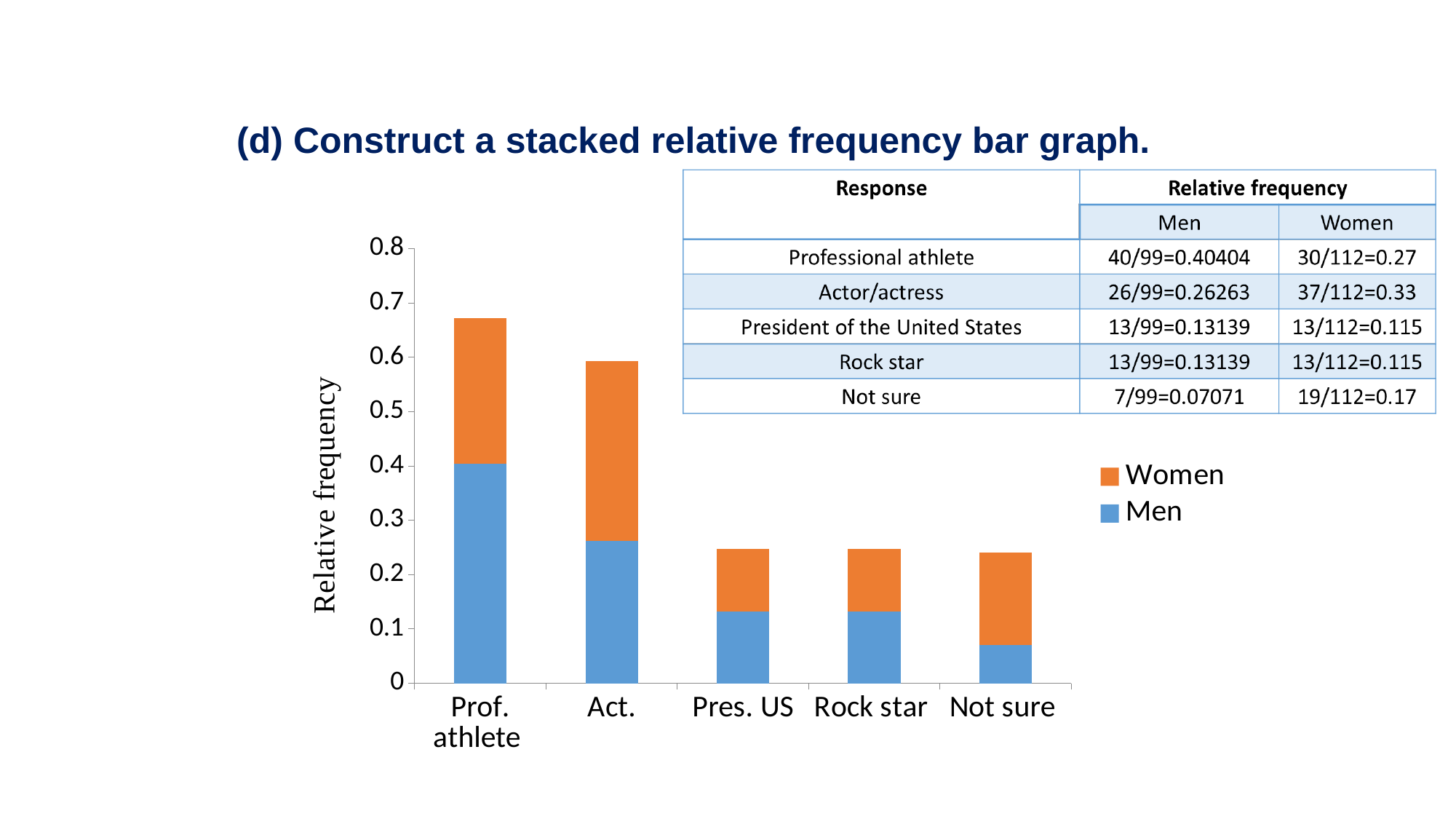
What is the label on the chart's vertical axis? Relative frequency What kind of chart is shown on the slide? bar chart Which colour represents Women in the chart's legend? orange How many series does the chart's legend list? 2 How many categories are shown on the x axis of the chart? 5 For the Not sure bar, which segment is larger, Women or Men? Women Which is larger, the Men segment for Prof. athlete or the Men segment for Act.? Prof. athlete Do the total bar heights rise or fall moving from left to right along the x axis? fall Is the Men segment for Prof. athlete greater or less than 0.3? greater Is the total height of the Act. bar greater or less than 0.5? greater Which category has the tallest stacked bar? Prof. athlete Is the Men segment for Not sure greater or less than 0.1? less